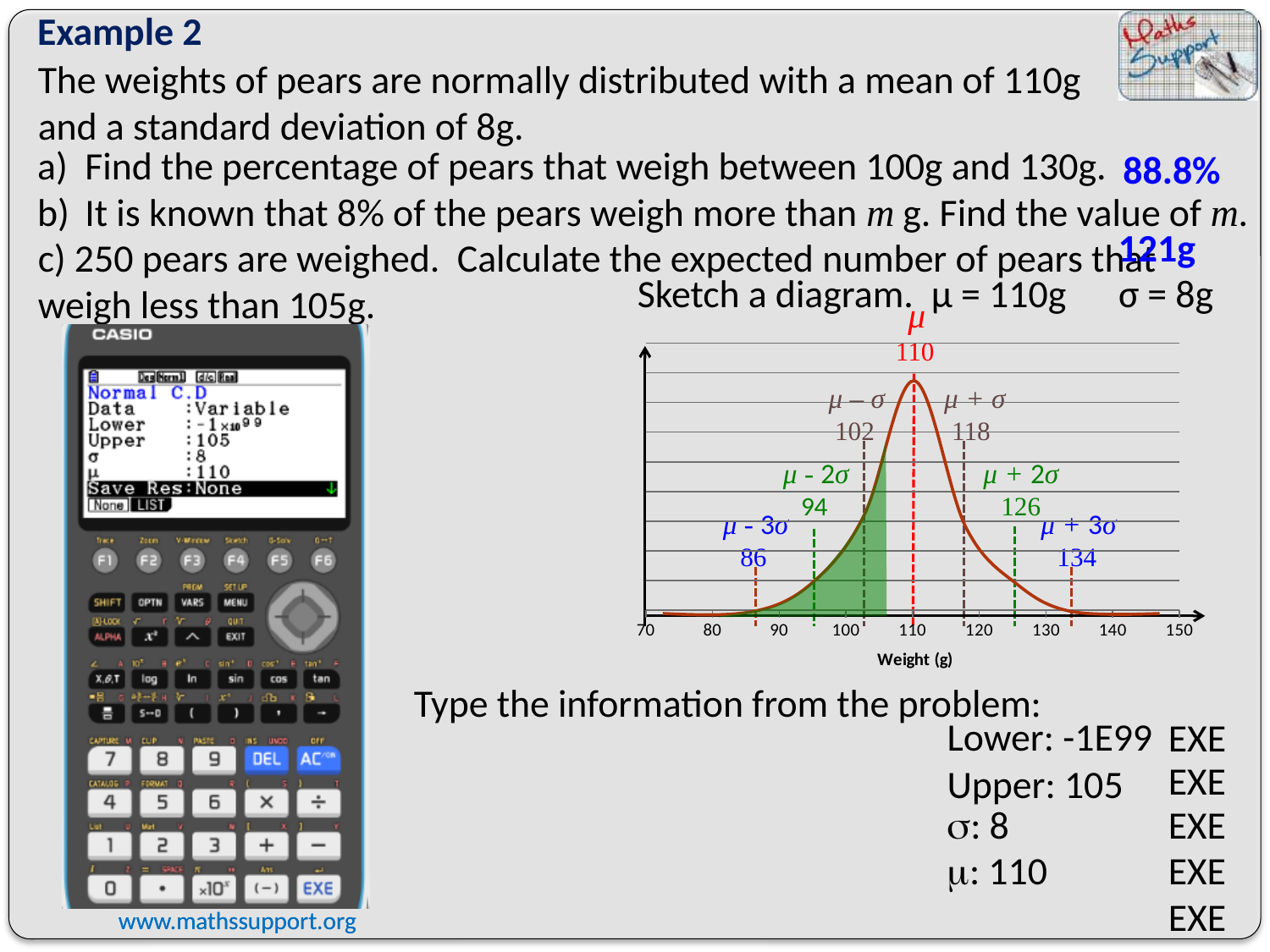
What value is marked at μ + 3σ on the normal distribution sketch? 134 What value is marked at the mean μ on the normal distribution sketch? 110 At which weight does the curve on the sketch reach its peak? 110 What value is marked at μ + σ on the normal distribution sketch? 118 What value is marked at μ − σ on the normal distribution sketch? 102 What is the difference between the values marked at μ + σ and μ − σ on the sketch? 16 What value is marked at μ − 3σ on the normal distribution sketch? 86 How many labelled tick values are shown on the x axis of the sketch? 9 What is the label of the x axis on the sketch? Weight (g) What value is marked at μ − 2σ on the normal distribution sketch? 94 What value is marked at μ + 2σ on the normal distribution sketch? 126 What kind of chart is the sketch of the weight distribution? line chart